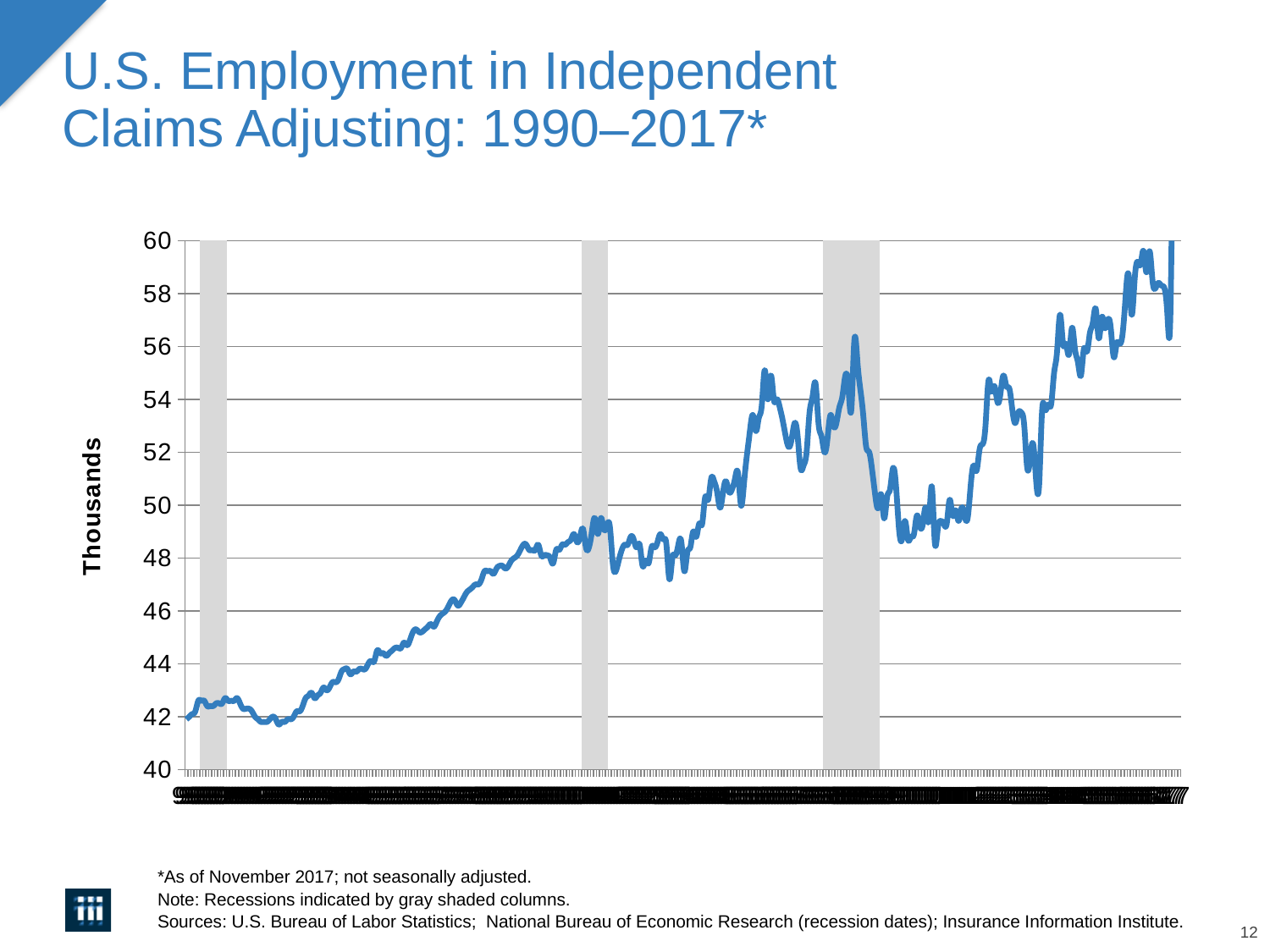
Overall, does the employment line rise or fall from the left end of the x axis to the right end? rise How many gray shaded recession columns appear on the chart? 3 What is the label on the vertical axis? Thousands Is the value at the left end of the line greater or less than 44? less What kind of chart is shown on the slide? line chart Is the highest value reached by the line greater or less than 58? greater Is the lowest value reached by the line greater or less than 44? less